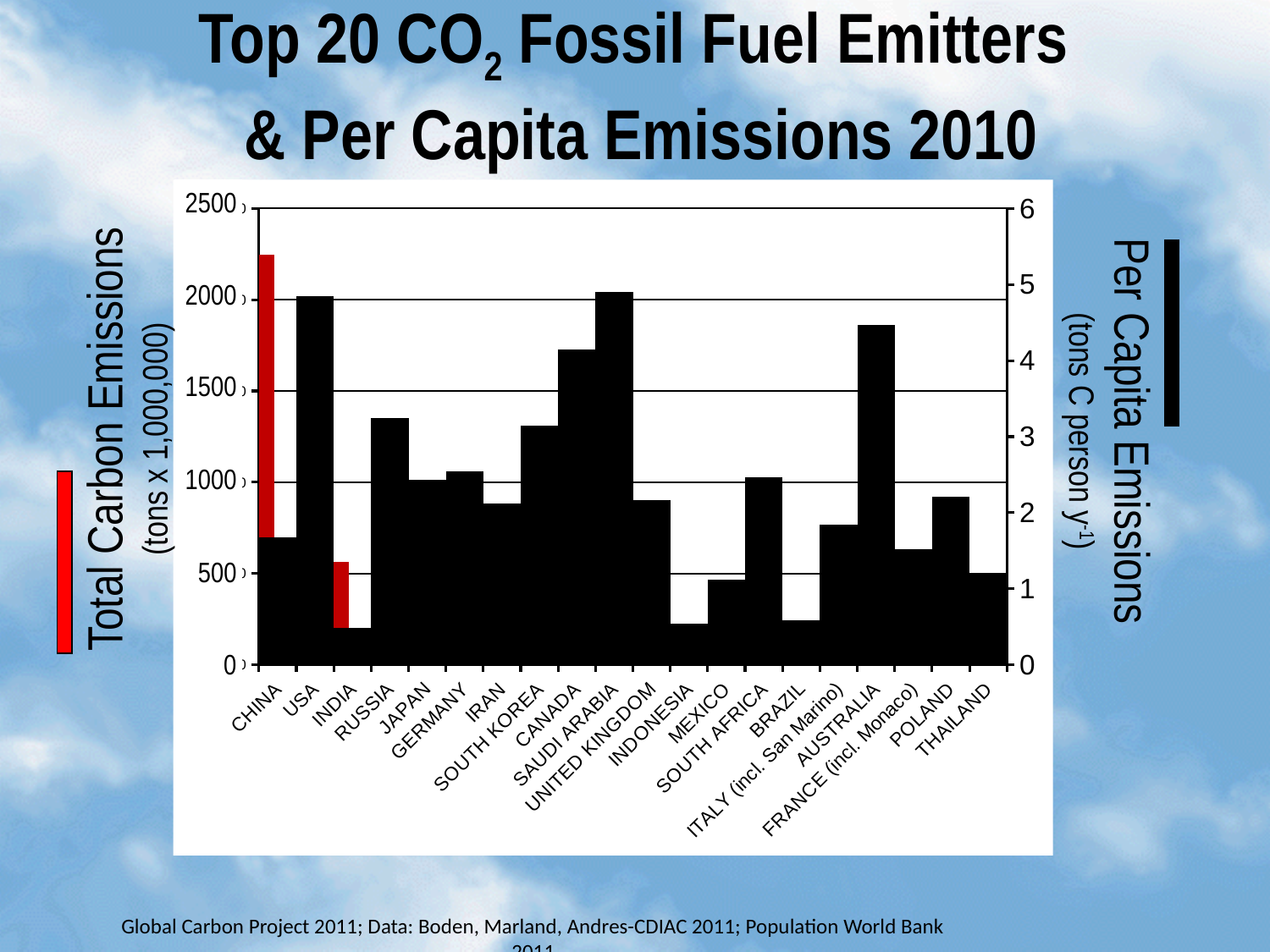
What colour are the Total Carbon Emissions bars in the chart? red What kind of chart is shown on the slide? bar chart Is the Total Carbon Emissions value for CHINA greater or less than 2000? greater How many series does the chart's legend list? 2 Is the Per Capita Emissions value for USA greater or less than 4? greater Which has the higher Total Carbon Emissions value, CHINA or INDIA? CHINA Is the Per Capita Emissions value for INDONESIA greater or less than 1? less How many countries are shown along the x axis of the chart? 20 Which has the higher Per Capita Emissions value, CANADA or JAPAN? CANADA Which has the higher Per Capita Emissions value, RUSSIA or MEXICO? RUSSIA